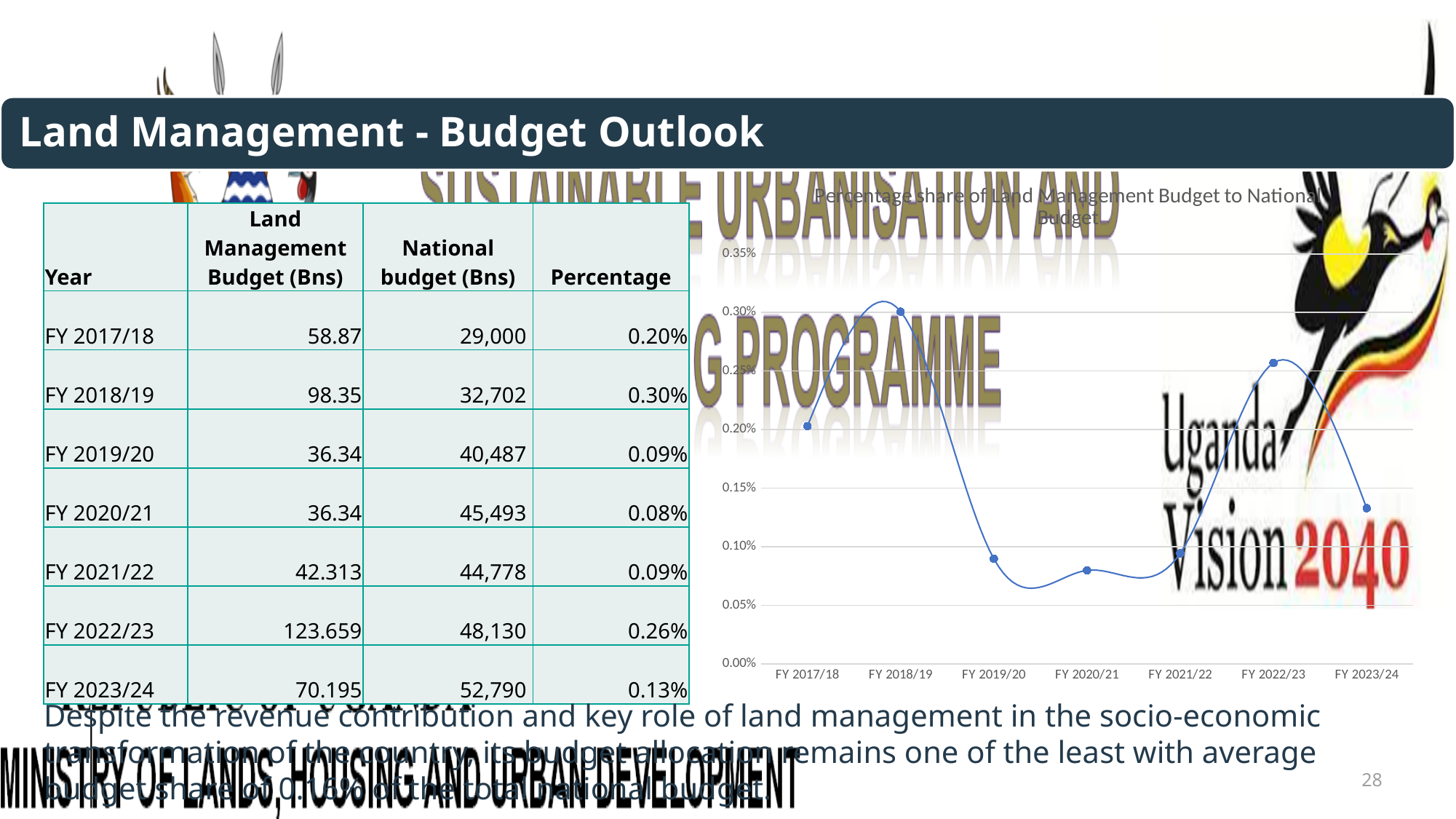
What is the title of the chart? Percentage share of Land Management Budget to National Budget What is the percentage share for FY 2018/19? 0.30% How many fiscal years are plotted on the chart? 7 Is the value for FY 2022/23 greater or less than 0.20%? greater What is the percentage share for FY 2017/18? 0.20% What is the percentage share for FY 2022/23? 0.26% What is the difference between the percentage share in FY 2018/19 and FY 2017/18? 0.10% Is the value for FY 2023/24 greater or less than 0.15%? less Does the percentage share rise or fall from FY 2018/19 to FY 2019/20? fall Which is larger, the percentage share for FY 2018/19 or for FY 2022/23? FY 2018/19 What kind of chart is shown on the slide? line chart Which fiscal year has the highest percentage share on the chart? FY 2018/19